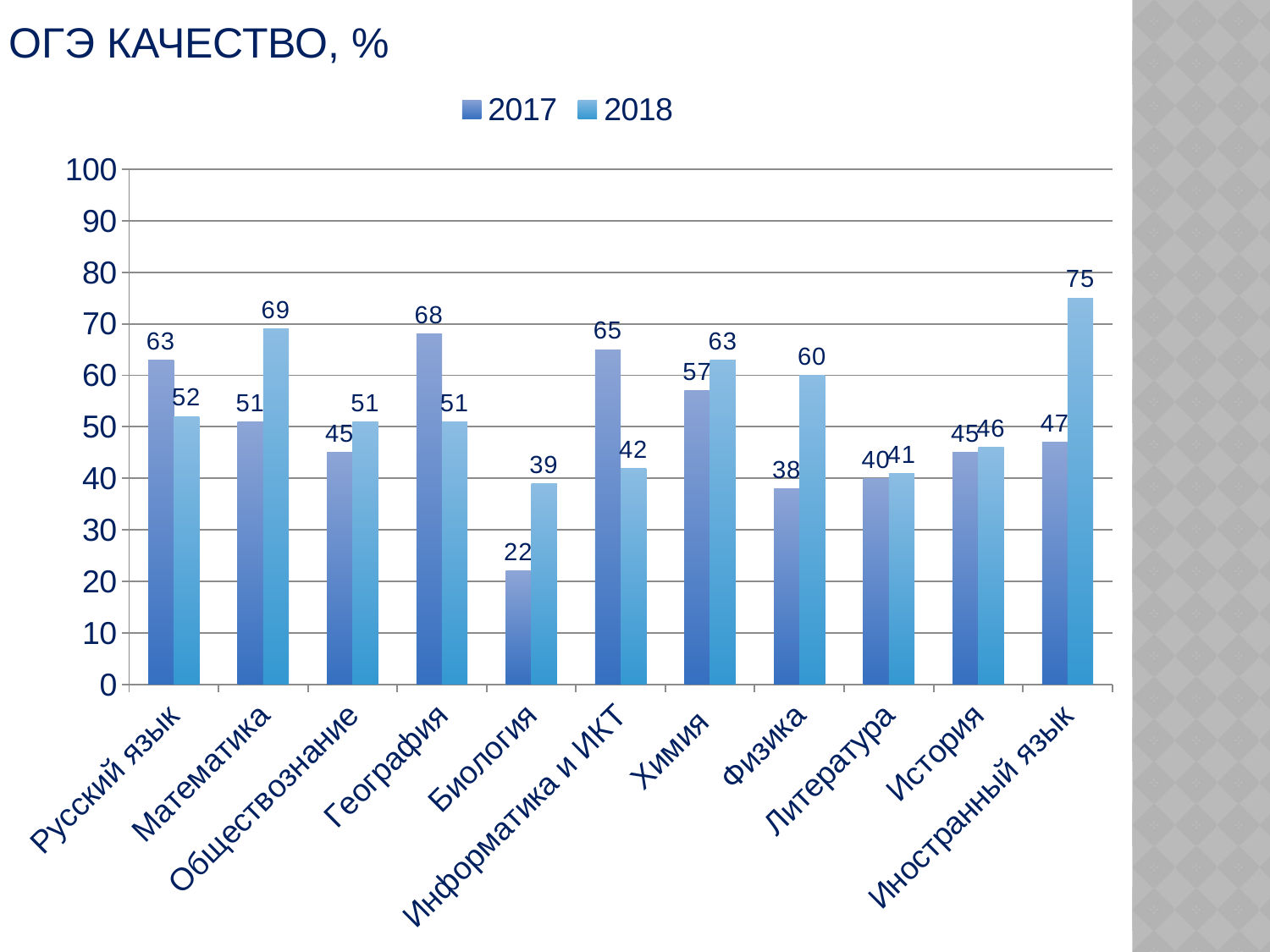
Is the 2018 value for Физика greater or less than 50? greater How many series does the legend list? 2 What is the 2017 value for Биология? 22 What is the title of the chart? ОГЭ КАЧЕСТВО, % What is the 2017 value for Информатика и ИКТ? 65 What is the 2018 value for Иностранный язык? 75 Which category has the lowest 2017 value? Биология Which is larger for География: the 2017 value or the 2018 value? 2017 Which category has the highest 2018 value? Иностранный язык What kind of chart is shown on the slide? bar chart How many categories are shown on the x axis? 11 What is the difference between the 2018 and 2017 values for Иностранный язык? 28